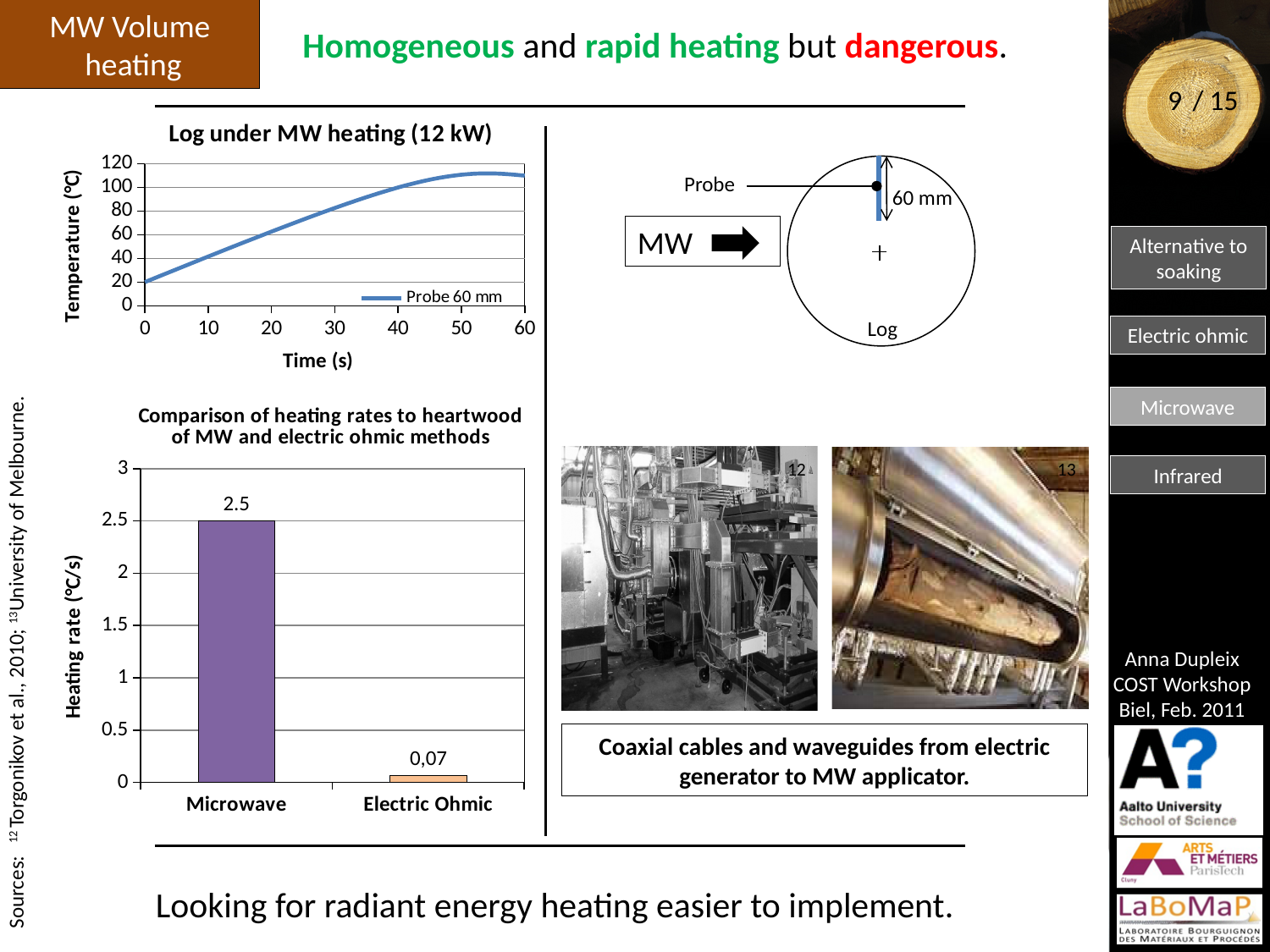
In the chart 'Log under MW heating (12 kW)', does the temperature rise or fall between 0 and 40 s? rise In the chart 'Log under MW heating (12 kW)', what is the name of the series in the legend? Probe 60 mm What kind of chart is 'Log under MW heating (12 kW)'? line chart In the bar chart 'Comparison of heating rates to heartwood of MW and electric ohmic methods', how many categories are shown? 2 In the bar chart 'Comparison of heating rates to heartwood of MW and electric ohmic methods', what is the heating rate for Electric Ohmic? 0,07 In the chart 'Log under MW heating (12 kW)', is the temperature at 40 s greater or less than 80? greater In the bar chart 'Comparison of heating rates to heartwood of MW and electric ohmic methods', which method has the higher heating rate? Microwave In the bar chart 'Comparison of heating rates to heartwood of MW and electric ohmic methods', what is the label of the y axis? Heating rate (°C/s) In the bar chart 'Comparison of heating rates to heartwood of MW and electric ohmic methods', what is the difference between the Microwave and Electric Ohmic heating rates? 2.43 In the chart 'Log under MW heating (12 kW)', how many series does the legend list? 1 In the bar chart 'Comparison of heating rates to heartwood of MW and electric ohmic methods', which method has the lowest heating rate? Electric Ohmic In the bar chart 'Comparison of heating rates to heartwood of MW and electric ohmic methods', what is the heating rate for Microwave? 2.5